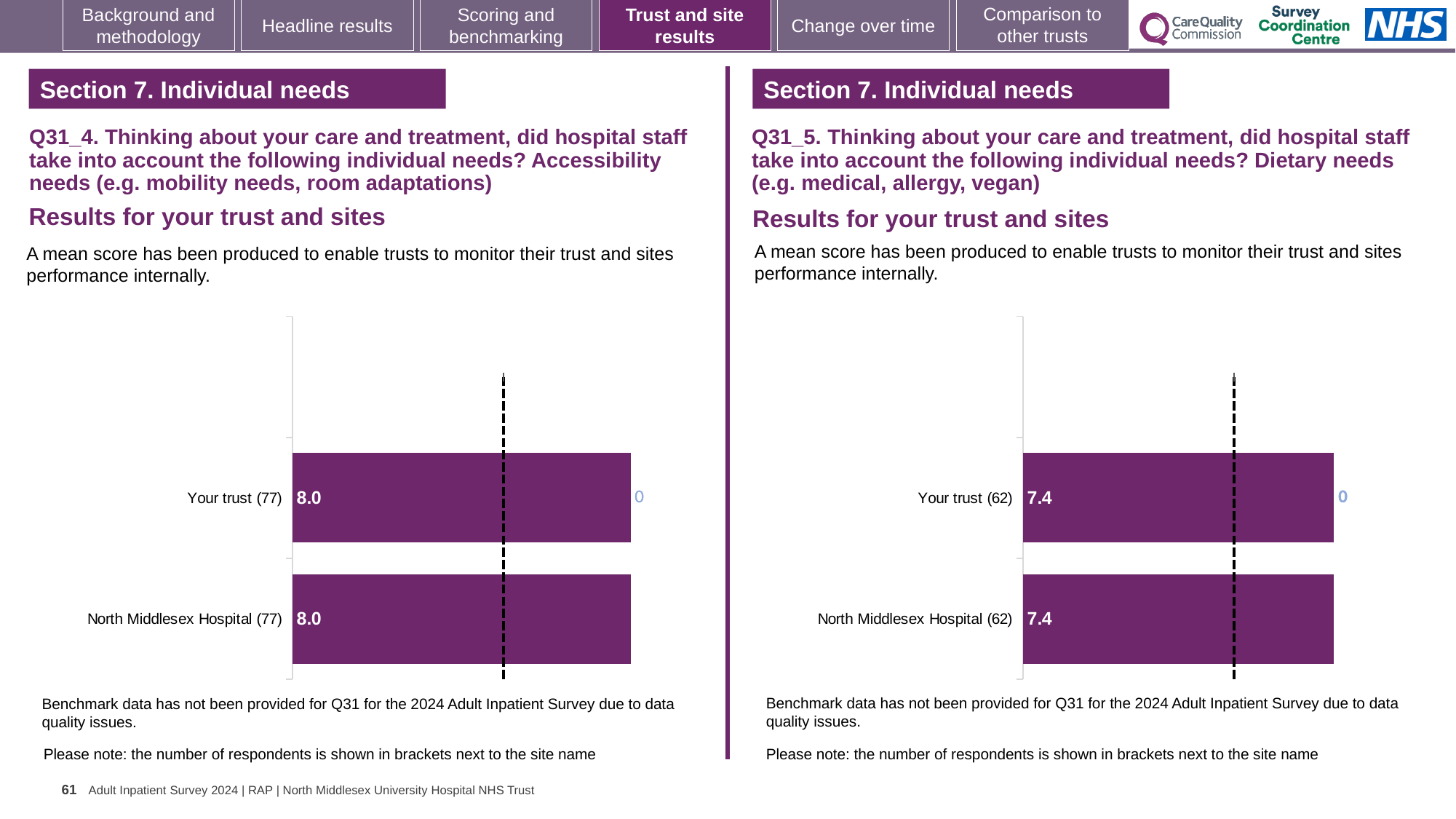
What kind of chart is used on the right (Q31_5, Dietary needs)? Bar chart On the left chart (Q31_4, Accessibility needs), how many respondents are shown in brackets next to Your trust? 77 What kind of chart is used on the left (Q31_4, Accessibility needs)? Bar chart What is the difference between the Your trust score on the left chart (Q31_4) and the Your trust score on the right chart (Q31_5)? 0.6 How many bars are plotted on the left chart (Q31_4, Accessibility needs)? 2 On the right chart (Q31_5, Dietary needs), what is the mean score for Your trust? 7.4 On the left chart (Q31_4, Accessibility needs), what is the mean score for North Middlesex Hospital? 8.0 On the right chart (Q31_5, Dietary needs), how many respondents are shown in brackets next to North Middlesex Hospital? 62 Which is larger: the Your trust score on the left chart (Q31_4, Accessibility needs) or the Your trust score on the right chart (Q31_5, Dietary needs)? Left chart (Q31_4), 8.0 How many categories are shown on the right chart (Q31_5, Dietary needs)? 2 On the left chart (Q31_4, Accessibility needs), what is the mean score for Your trust? 8.0 On the right chart (Q31_5, Dietary needs), what is the mean score for North Middlesex Hospital? 7.4